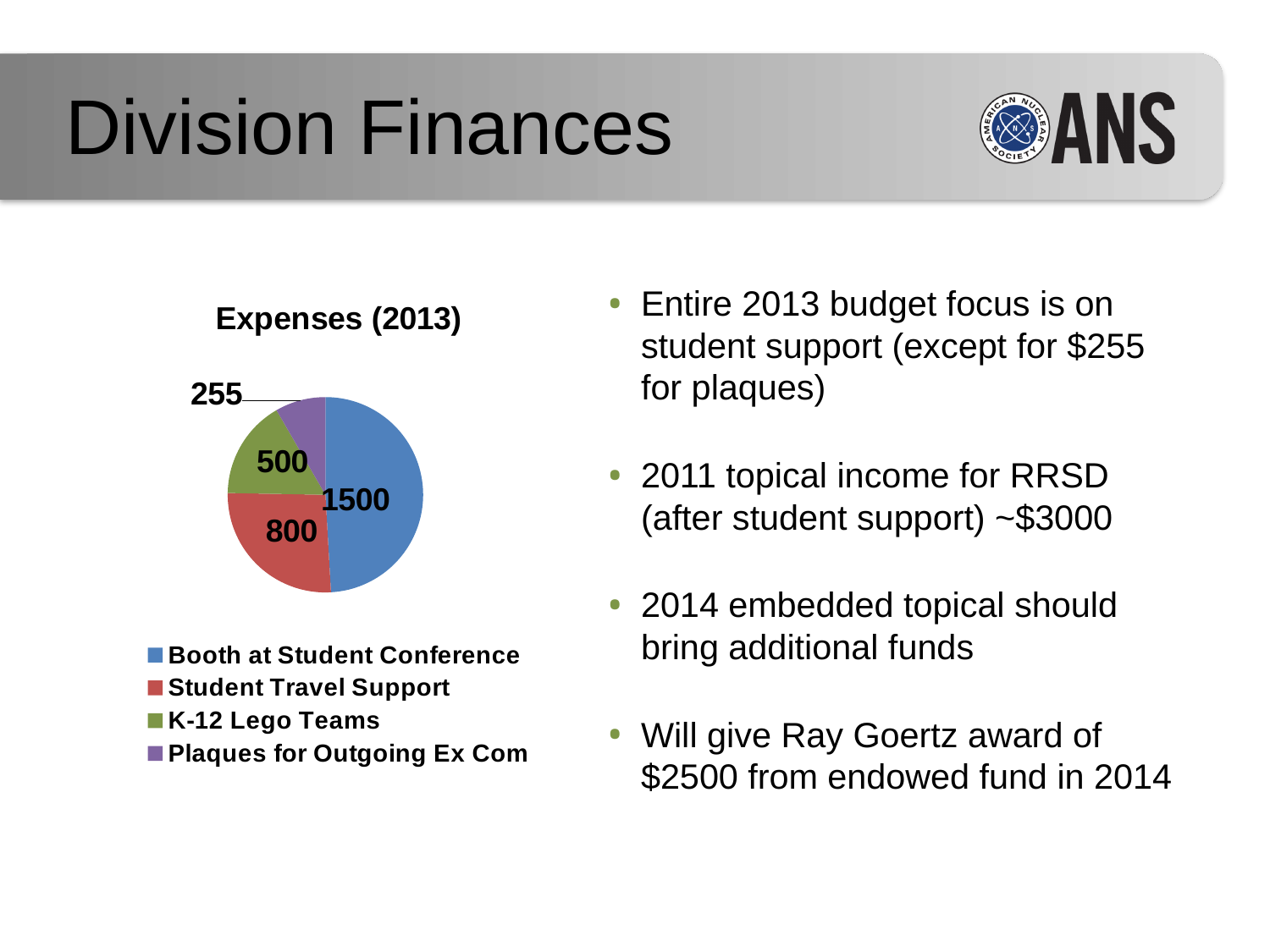
What type of chart is shown under the title "Expenses (2013)"? pie chart Which category has the smallest slice in the Expenses (2013) pie chart? Plaques for Outgoing Ex Com What is the value for Plaques for Outgoing Ex Com in the Expenses (2013) pie chart? 255 What is the value for Student Travel Support in the Expenses (2013) pie chart? 800 How many categories are shown in the Expenses (2013) pie chart? 4 What is the value for Booth at Student Conference in the Expenses (2013) pie chart? 1500 What colour is the Student Travel Support slice in the Expenses (2013) pie chart? red What is the value for K-12 Lego Teams in the Expenses (2013) pie chart? 500 What is the total of all slices in the Expenses (2013) pie chart? 3055 Which category has the largest slice in the Expenses (2013) pie chart? Booth at Student Conference Which is larger in the Expenses (2013) pie chart: K-12 Lego Teams or Plaques for Outgoing Ex Com? K-12 Lego Teams What is the difference between the Booth at Student Conference and Student Travel Support values in the Expenses (2013) pie chart? 700